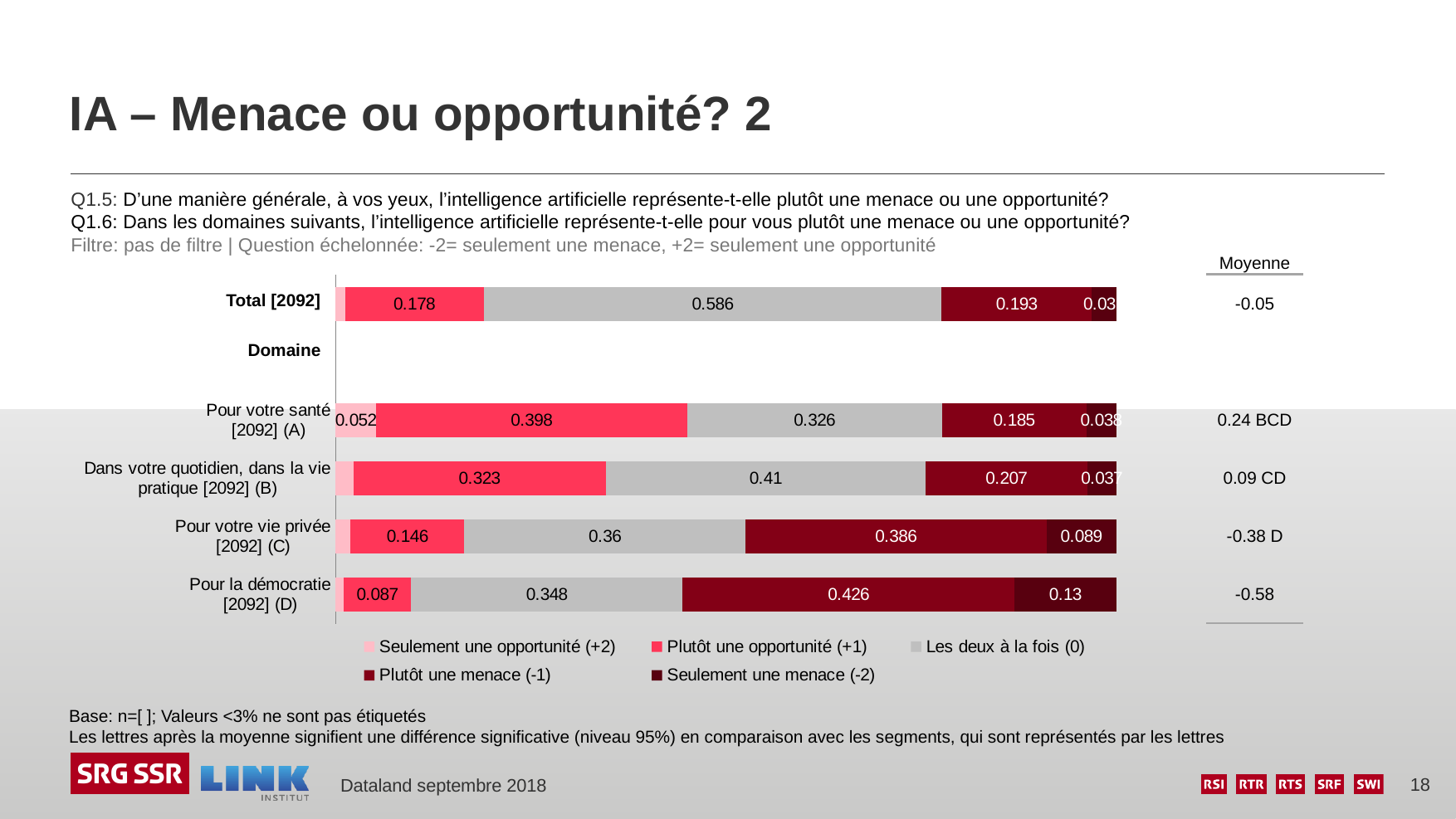
What kind of chart is shown on the slide? Stacked bar chart What is the Moyenne shown for 'Pour la démocratie [2092] (D)'? -0.58 What is the value of 'Plutôt une opportunité (+1)' for 'Pour votre santé [2092] (A)'? 0.398 How many series does the legend list? 5 What is the difference between the 'Plutôt une menace (-1)' values for 'Pour la démocratie [2092] (D)' and 'Pour votre santé [2092] (A)'? 0.241 What is the value of 'Plutôt une menace (-1)' for 'Pour la démocratie [2092] (D)'? 0.426 What is the title of the slide containing the chart? IA – Menace ou opportunité? 2 Which category has the highest value for 'Plutôt une menace (-1)'? Pour la démocratie [2092] (D) What is the value of 'Les deux à la fois (0)' for Total [2092]? 0.586 Which is larger: the 'Les deux à la fois (0)' value for Total [2092] or for 'Dans votre quotidien, dans la vie pratique [2092] (B)'? Total [2092] Which category has the lowest value for 'Plutôt une opportunité (+1)'? Pour la démocratie [2092] (D) What is the value of 'Seulement une menace (-2)' for 'Pour votre vie privée [2092] (C)'? 0.089